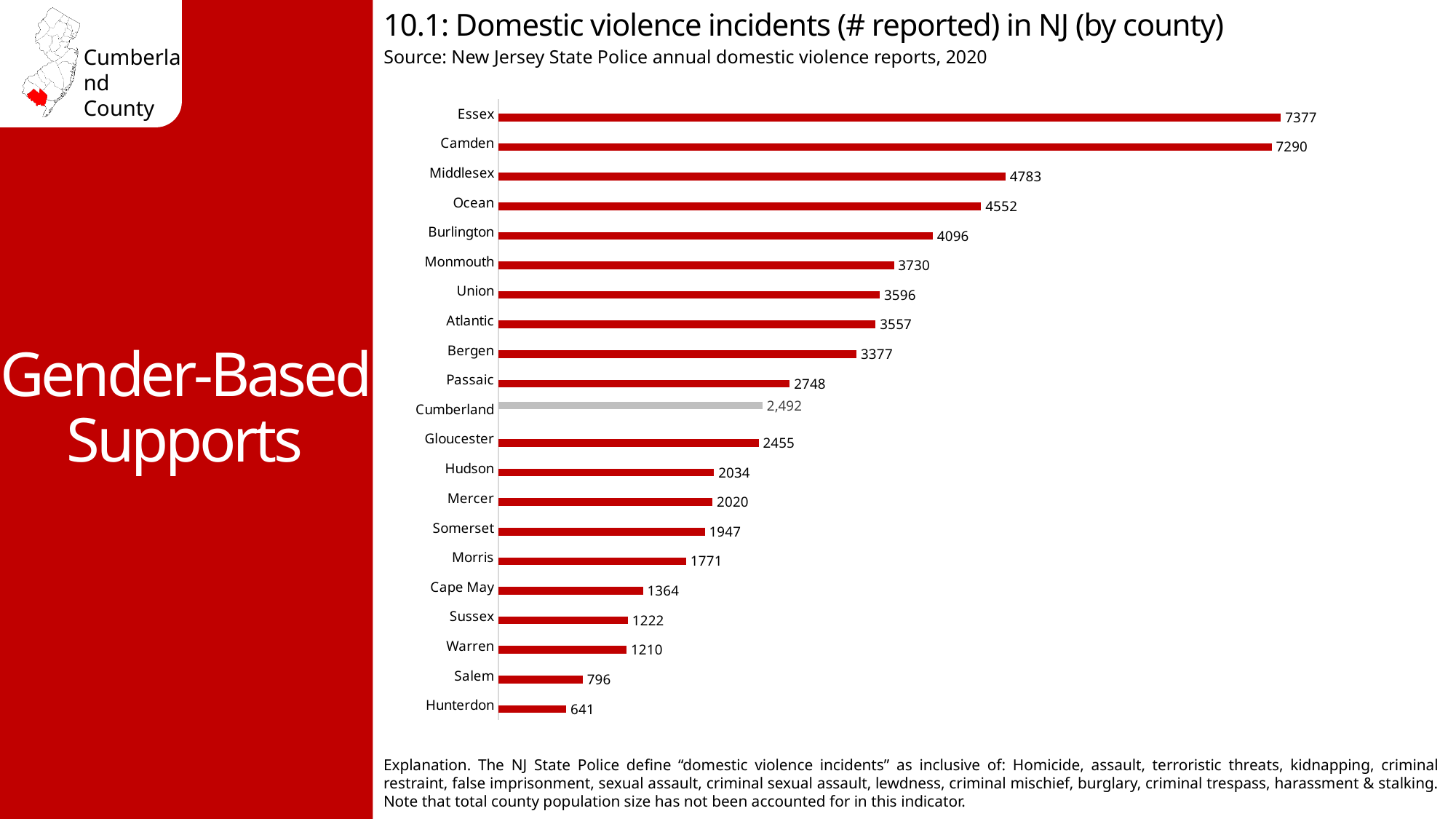
What is the number of domestic violence incidents reported for Essex? 7377 What is the value shown for Cumberland? 2,492 Which county has the highest number of reported domestic violence incidents? Essex What kind of chart is shown on the slide? Bar chart Which has a higher value, Monmouth or Bergen? Monmouth What is the difference between the values for Middlesex and Ocean? 231 Which county's bar is shown in grey rather than red? Cumberland Which county has the lowest number of reported domestic violence incidents? Hunterdon What is the difference between the values for Essex and Camden? 87 How many domestic violence incidents are reported for Hunterdon? 641 Which has a lower value, Salem or Warren? Salem How many counties are shown in the chart? 21